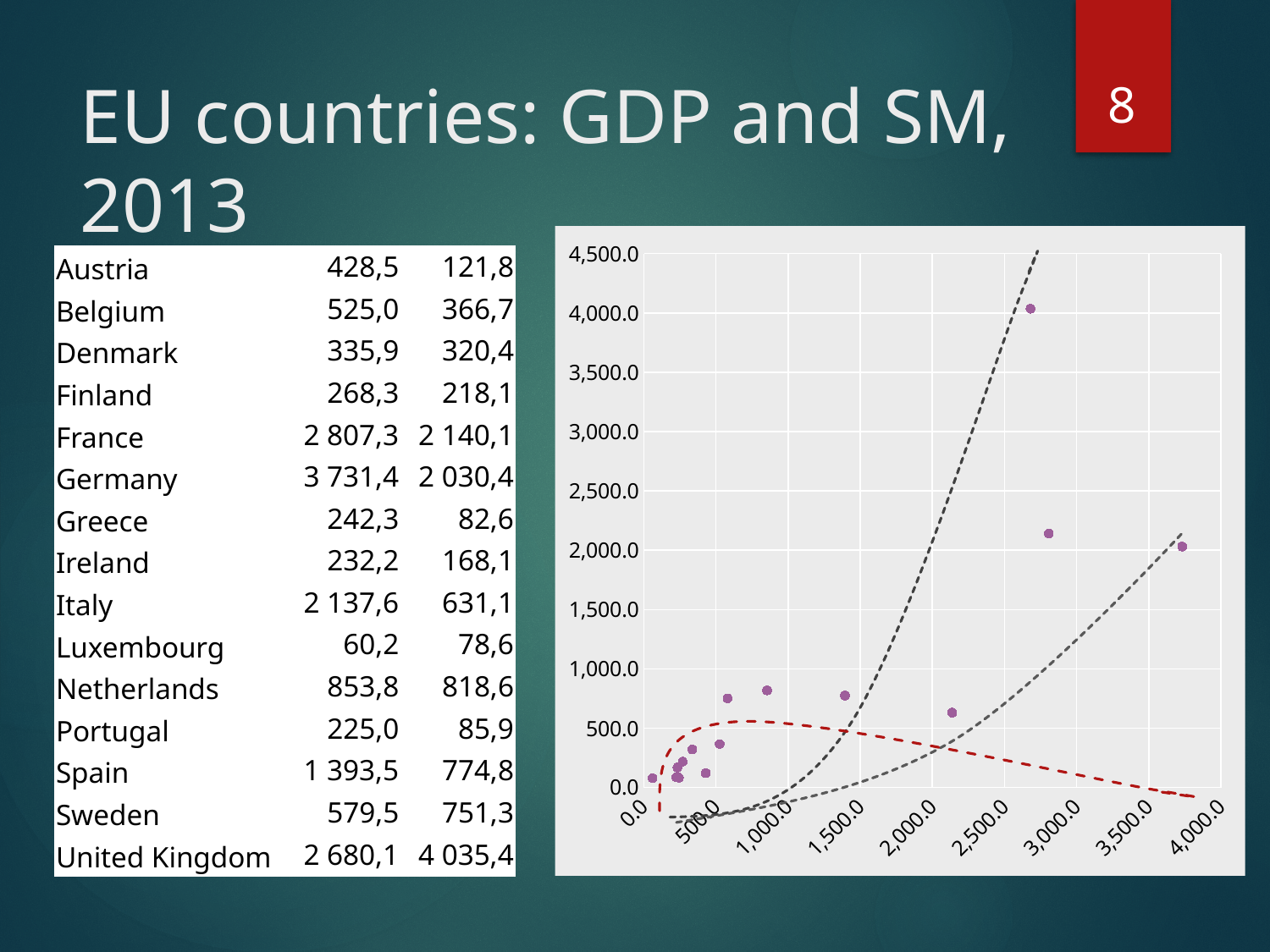
What is the highest value shown on the horizontal axis of the chart? 4,000.0 Is the vertical value of the point plotted near 2,100 on the horizontal axis greater or less than 1,000? less According to the table, which has the larger second-column value, France or Germany? France According to the table, which country has the highest value in the second column (the vertical axis of the chart)? United Kingdom Does the red dashed line on the chart rise or fall as it moves toward the right end of the x axis? fall How many dashed trend lines are drawn on the chart? 3 According to the table, what is the first-column value for Germany? 3 731,4 What kind of chart is shown on the slide? scatter chart According to the table, which country has the lowest value in the first column (the horizontal axis of the chart)? Luxembourg What is the highest value shown on the vertical axis of the chart? 4,500.0 Is the vertical value of the point plotted near 2,800 on the horizontal axis greater or less than 1,500? greater Is the vertical value of the point plotted near 3,700 on the horizontal axis greater or less than 2,500? less